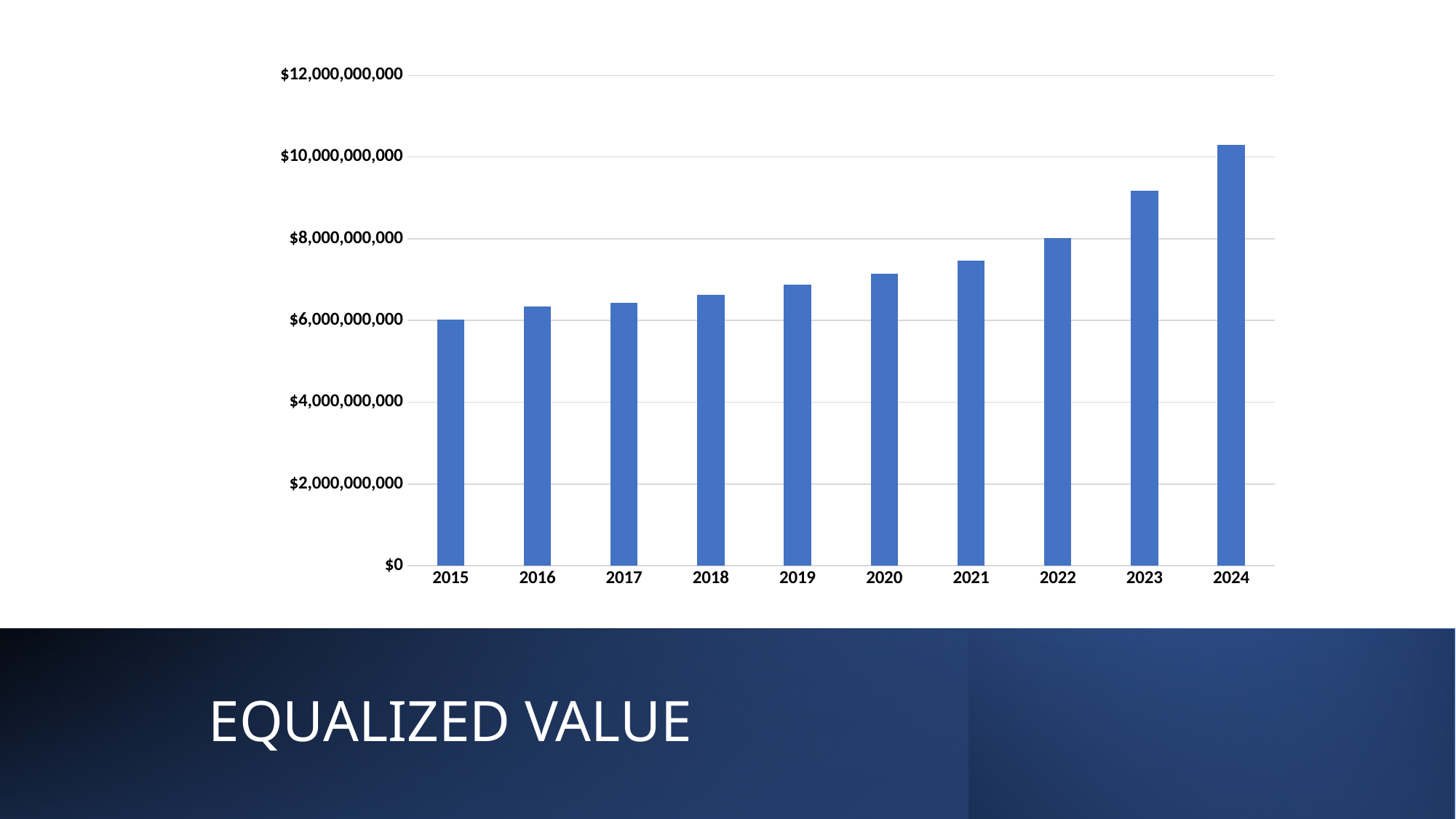
What is the title shown on the slide for this chart? EQUALIZED VALUE Which year has the highest equalized value? 2024 Is the value for 2024 greater or less than $10,000,000,000? greater Is the value for 2021 greater or less than $8,000,000,000? less Do the values rise or fall from 2015 to 2024? rise How many years are plotted on the x axis of the chart? 10 What kind of chart is shown on the slide? bar chart Which year has the lowest equalized value? 2015 What is the highest tick label on the y axis? $12,000,000,000 Is the value for 2023 greater or less than $8,000,000,000? greater Which is larger, the value for 2023 or the value for 2020? 2023